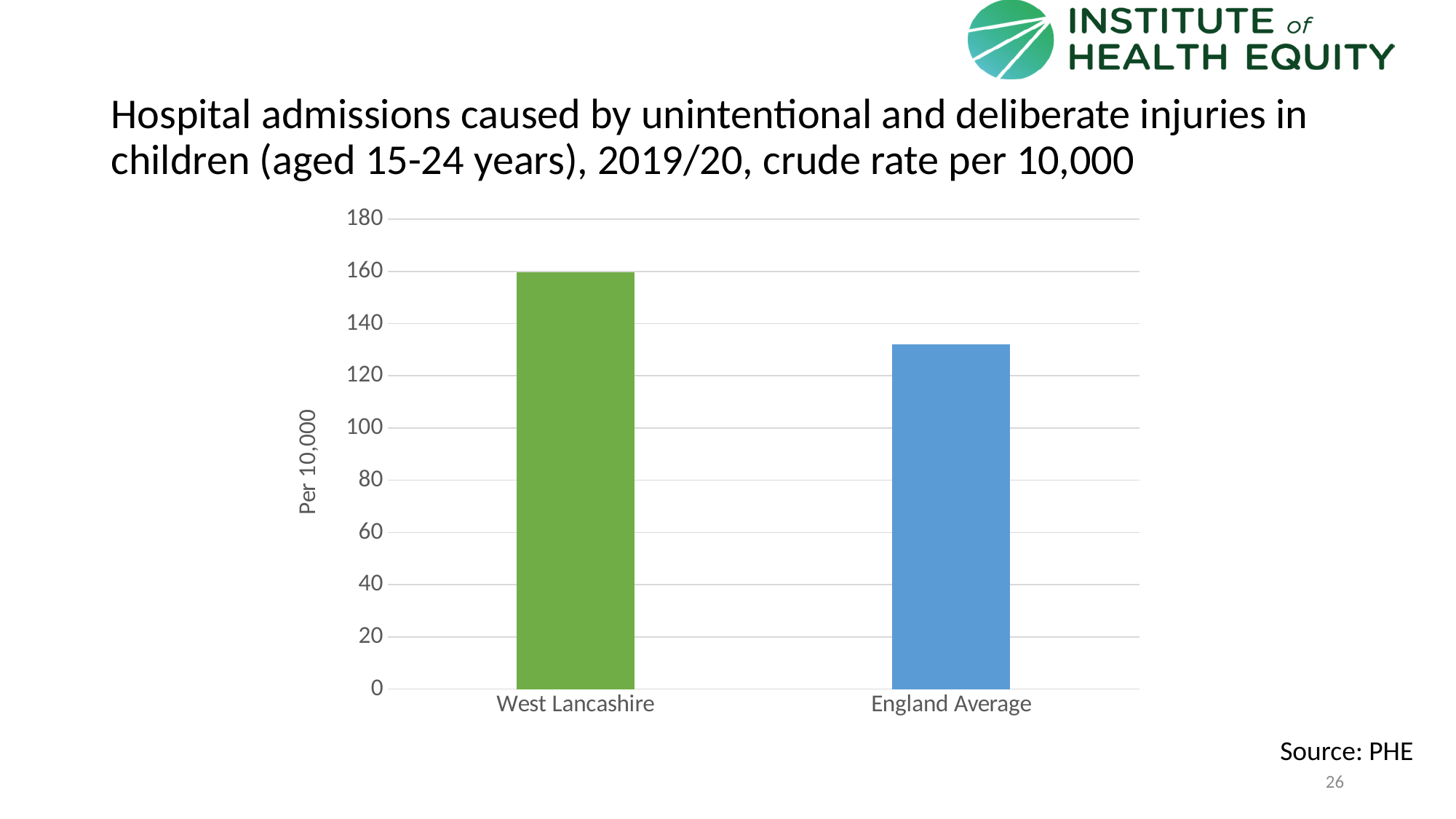
Which category has the highest value? West Lancashire Is the value for England Average greater or less than 120? greater Which is larger, the value for West Lancashire or the value for England Average? West Lancashire Is the value for England Average greater or less than 140? less What is the label on the vertical axis of the chart? Per 10,000 What kind of chart is shown on the slide? bar chart Is the value for West Lancashire greater or less than 140? greater What source is cited for the chart? PHE How many categories are plotted on the chart? 2 Which category has the lowest value? England Average